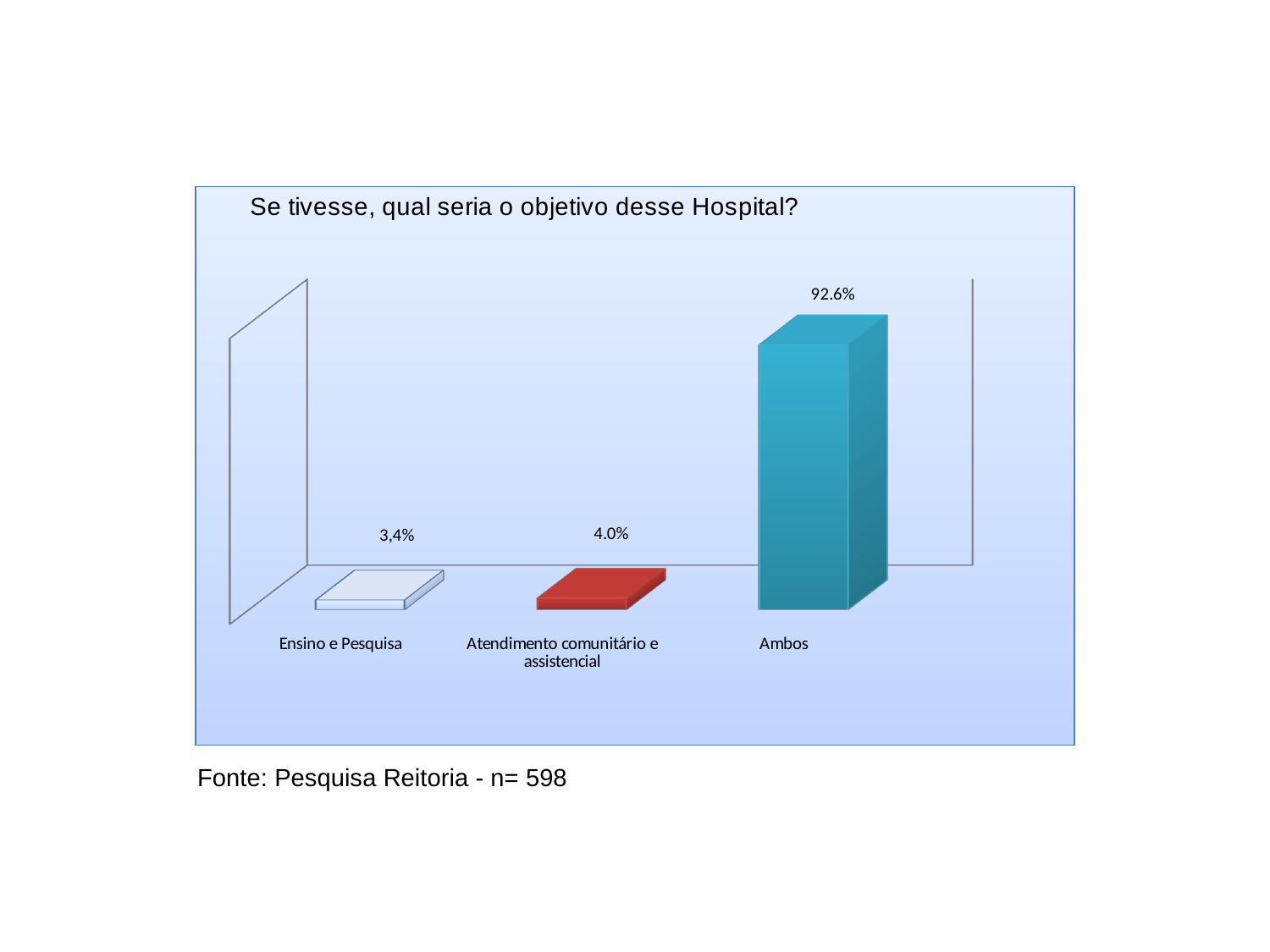
What colour is the bar for Atendimento comunitário e assistencial? Red Which category has the lowest value? Ensino e Pesquisa What is the difference between the values for Ambos and Atendimento comunitário e assistencial? 88.6% Which category has the highest value? Ambos What kind of chart is shown on the slide? Bar chart What is the difference between the values for Atendimento comunitário e assistencial and Ensino e Pesquisa? 0.6% What is the value for Atendimento comunitário e assistencial? 4.0% How many categories are shown in the chart? 3 What is the value for Ambos? 92.6% What is the title of the chart? Se tivesse, qual seria o objetivo desse Hospital? What is the value for Ensino e Pesquisa? 3,4% Which is larger, the value for Ensino e Pesquisa or the value for Atendimento comunitário e assistencial? Atendimento comunitário e assistencial